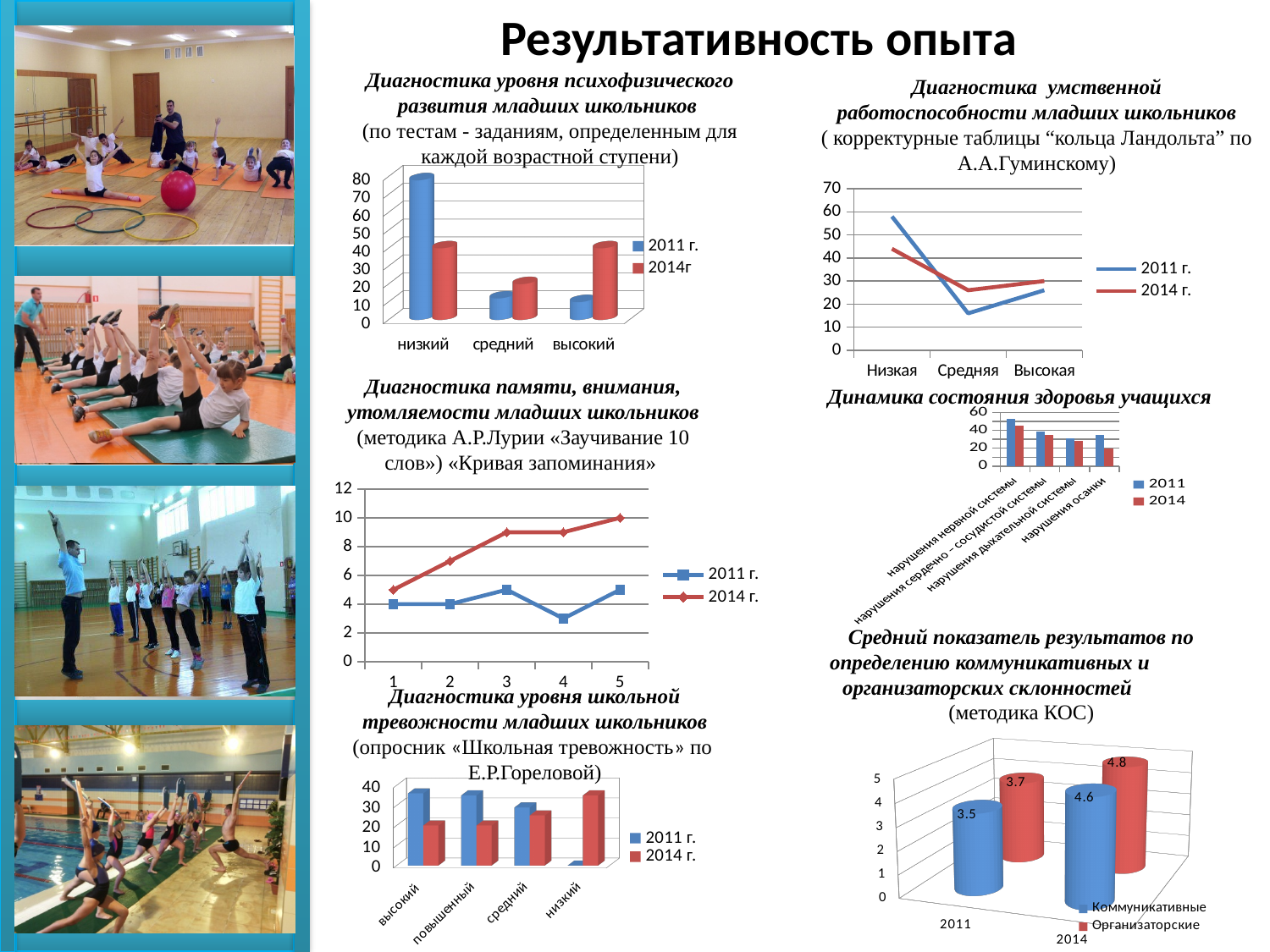
On the chart 'Диагностика умственной работоспособности младших школьников', which category has the lowest value for 2011 г.? Средняя On the chart 'Диагностика умственной работоспособности младших школьников', is the value for Низкая in 2011 г. greater or less than 50? greater On the chart 'Динамика состояния здоровья учащихся', how many categories are shown? 4 On the chart 'Диагностика памяти, внимания, утомляемости младших школьников', how many points are on the x axis? 5 On the chart 'Диагностика уровня школьной тревожности младших школьников', which series has the larger value for низкий? 2014 г. On the chart 'Диагностика уровня психофизического развития младших школьников', which category has the highest value for 2011 г.? низкий On the chart 'Средний показатель результатов по определению коммуникативных и организаторских склонностей', which series has the higher value in 2014? Организаторские On the chart 'Диагностика памяти, внимания, утомляемости младших школьников', does the 2014 г. line rise or fall from point 1 to point 5? rise On the chart 'Средний показатель результатов по определению коммуникативных и организаторских склонностей', what is the value for Коммуникативные in 2011? 3.5 On the chart 'Диагностика уровня психофизического развития младших школьников', is the value for низкий in 2011 г. greater or less than 70? greater On the chart 'Средний показатель результатов по определению коммуникативных и организаторских склонностей', what is the value for Организаторские in 2014? 4.8 On the chart 'Средний показатель результатов по определению коммуникативных и организаторских склонностей', what is the difference between the Организаторские values for 2014 and 2011? 1.1